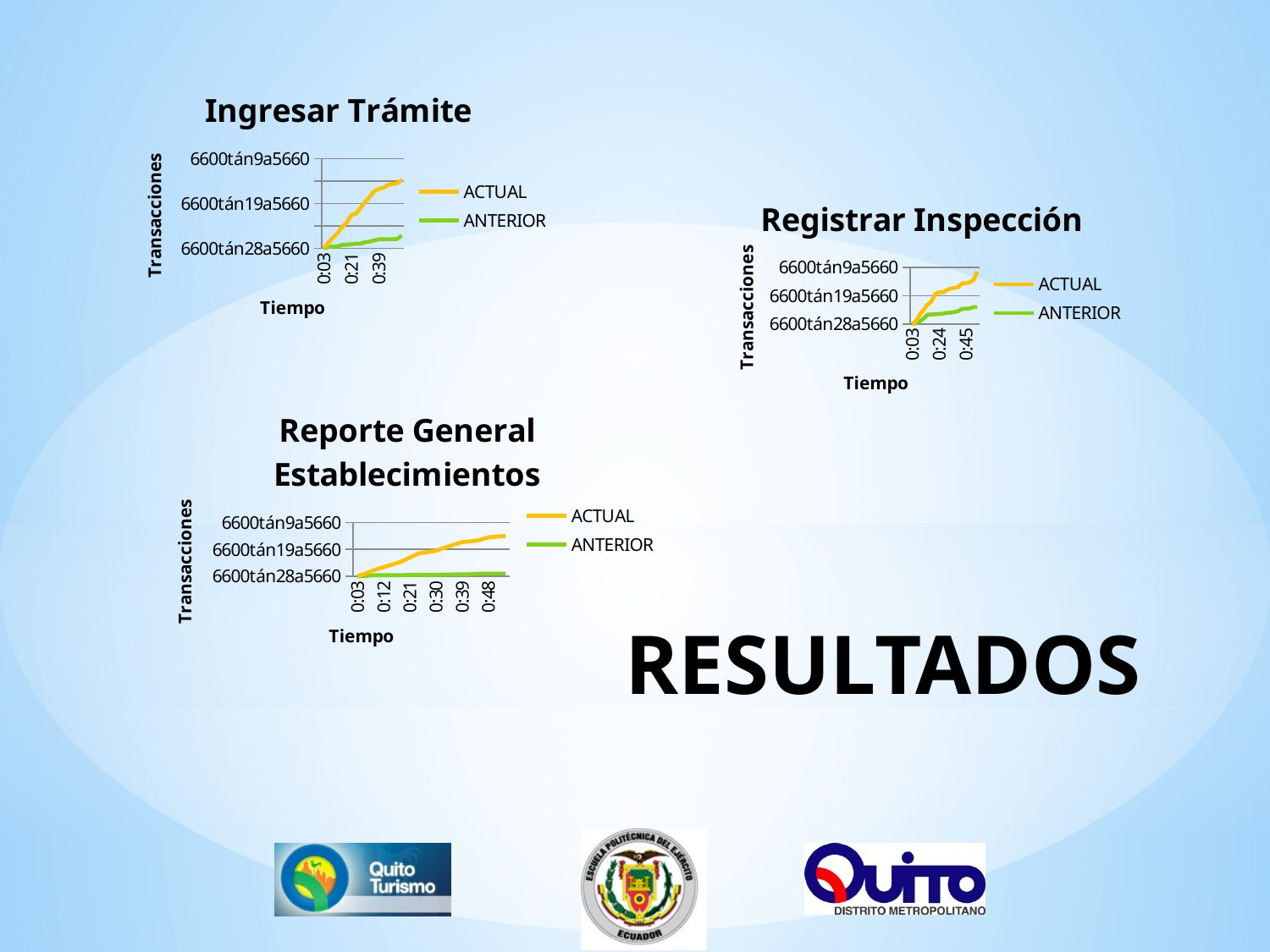
In the "Ingresar Trámite" chart, does the ACTUAL line rise or fall as time increases along the x axis? rise What is the last x-axis tick label on the "Registrar Inspección" chart? 0:45 How many line charts are shown on the slide? 3 What is the first x-axis tick label on the "Ingresar Trámite" chart? 0:03 What kind of chart is the "Ingresar Trámite" chart? line chart In the "Reporte General Establecimientos" chart, which series stays lower throughout, ACTUAL or ANTERIOR? ANTERIOR In the "Registrar Inspección" chart, which series reaches the higher value at the end of the time axis, ACTUAL or ANTERIOR? ACTUAL What is the x-axis title of the "Registrar Inspección" chart? Tiempo How many series does the legend of the "Registrar Inspección" chart list? 2 What are the two series named in the legend of the "Reporte General Establecimientos" chart? ACTUAL and ANTERIOR In the "Reporte General Establecimientos" chart, does the ACTUAL line rise or fall from 0:03 to 0:48? rise How many tick labels are shown on the x axis of the "Reporte General Establecimientos" chart? 6